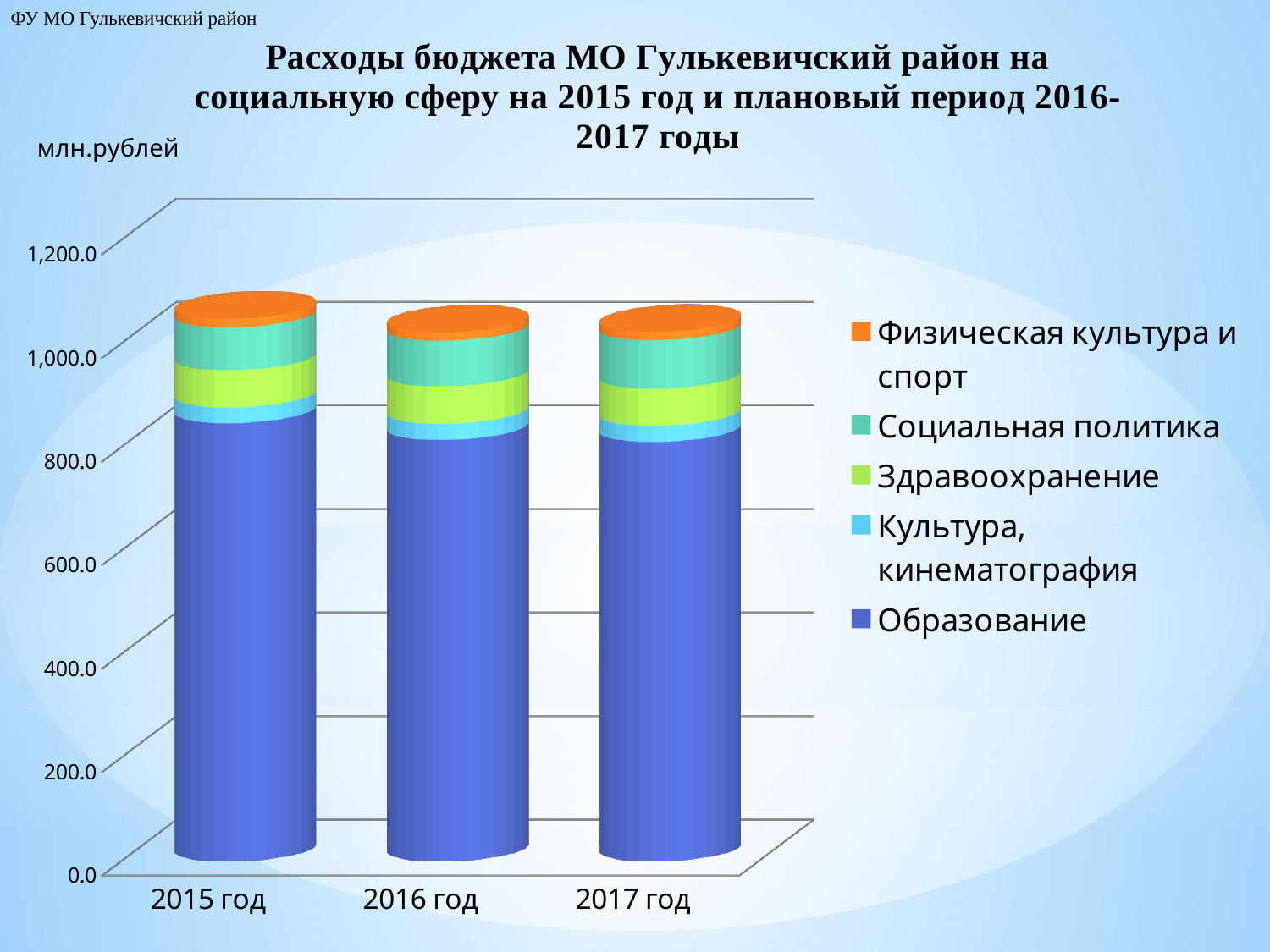
Which year has the highest total bar? 2015 год Which series makes up the largest part of each bar? Образование What unit is indicated for the values on the chart? млн.рублей Is the value of Образование for 2015 год greater or less than 800? greater Which is larger, the total bar for 2015 год or for 2016 год? 2015 год Is the value of Образование for 2017 год greater or less than 600? greater How many series does the legend list? 5 What kind of chart is shown on the slide? stacked bar chart Is the total value of the bar for 2015 год greater or less than 1,000? greater Which series is shown in orange in the legend? Физическая культура и спорт How many years (categories) are shown on the x axis? 3